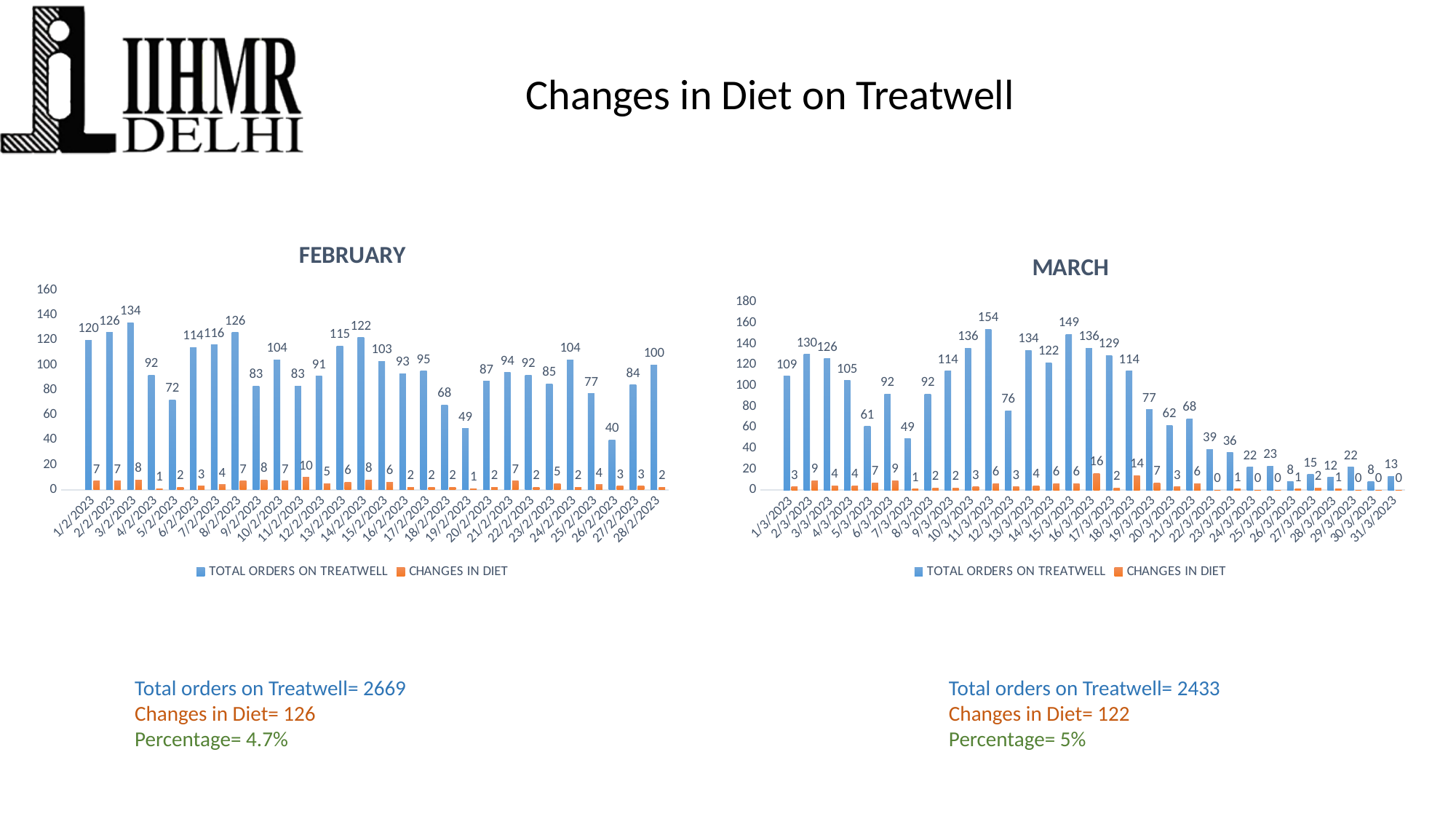
In the FEBRUARY chart, what is the difference between TOTAL ORDERS ON TREATWELL on 1/2/2023 and on 5/2/2023? 48 In the MARCH chart, which is larger, TOTAL ORDERS ON TREATWELL on 2/3/2023 or on 15/3/2023? 15/3/2023 In the MARCH chart, do the TOTAL ORDERS ON TREATWELL values generally rise or fall from 16/3/2023 to 31/3/2023? Fall In the FEBRUARY chart, what is the value of CHANGES IN DIET on 12/2/2023? 5 In the FEBRUARY chart, on which date is TOTAL ORDERS ON TREATWELL lowest? 26/2/2023 In the MARCH chart, what is the value of TOTAL ORDERS ON TREATWELL on 11/3/2023? 154 In the FEBRUARY chart, what is the value of TOTAL ORDERS ON TREATWELL on 3/2/2023? 134 In the MARCH chart, what is the value of CHANGES IN DIET on 19/3/2023? 7 In the FEBRUARY chart, how many series does the legend list? 2 In the MARCH chart, how many dates are shown on the x axis? 31 What kind of chart is the MARCH chart? Bar chart In the MARCH chart, on which date is CHANGES IN DIET highest? 16/3/2023